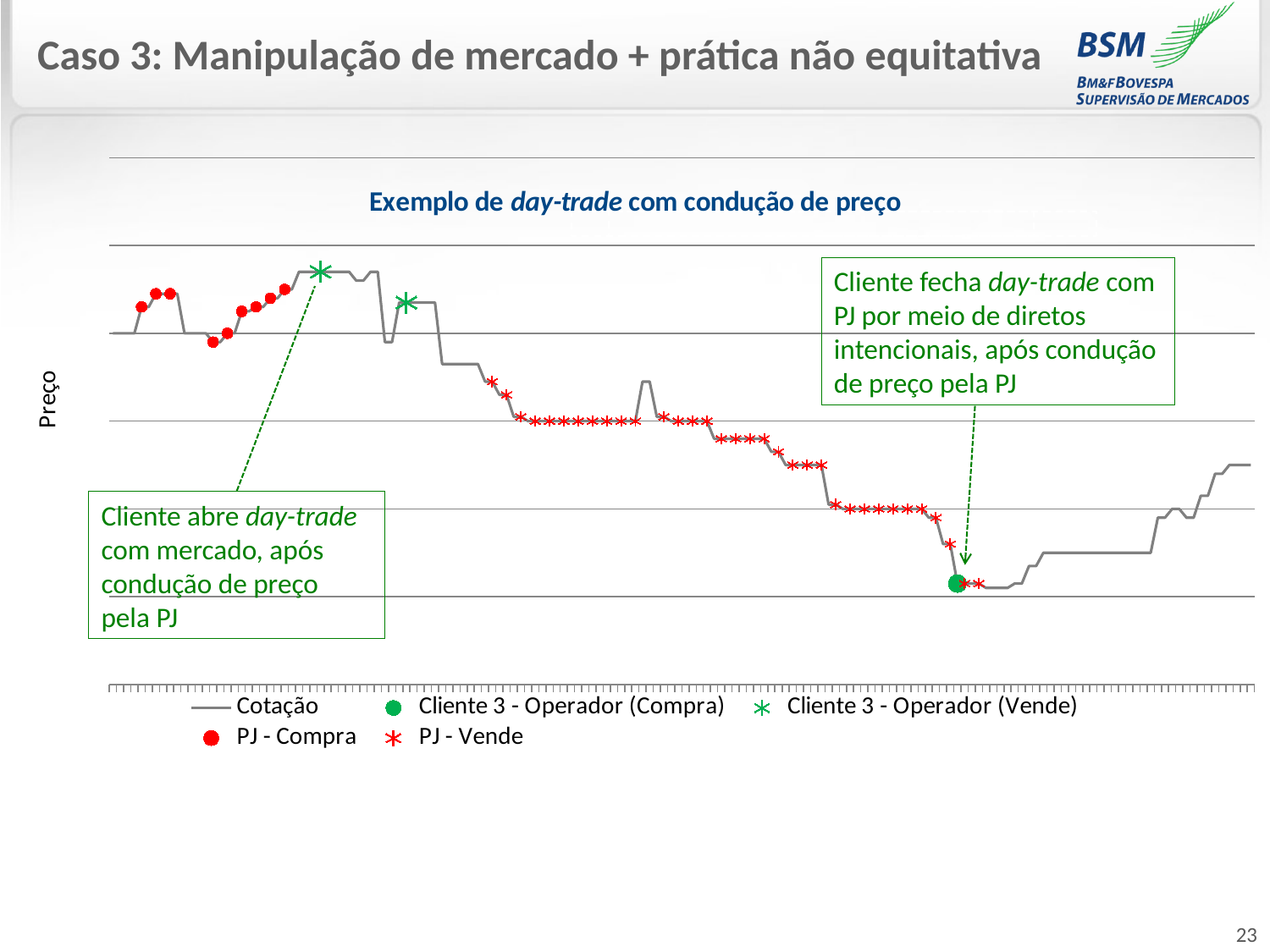
Between the green asterisk sell markers and the green circle buy marker, does the Cotação line mostly rise or fall? fall How many green asterisk markers (Cliente 3 - Operador (Vende)) are plotted on the chart? 2 How many series does the chart legend list? 5 Which legend entry is represented by a red asterisk marker? PJ - Vende Does the Cotação line end higher or lower than where it starts on the left of the chart? lower What kind of chart is shown on the slide? line chart Which series' markers appear along the falling section of the price line in the middle of the chart? PJ - Vende What is the label on the vertical axis of the chart? Preço How many green circle markers (Cliente 3 - Operador (Compra)) are plotted on the chart? 1 Is the price at which Cliente 3 - Operador buys (green circle) higher or lower than the price at which Cliente 3 - Operador sells (green asterisks)? lower